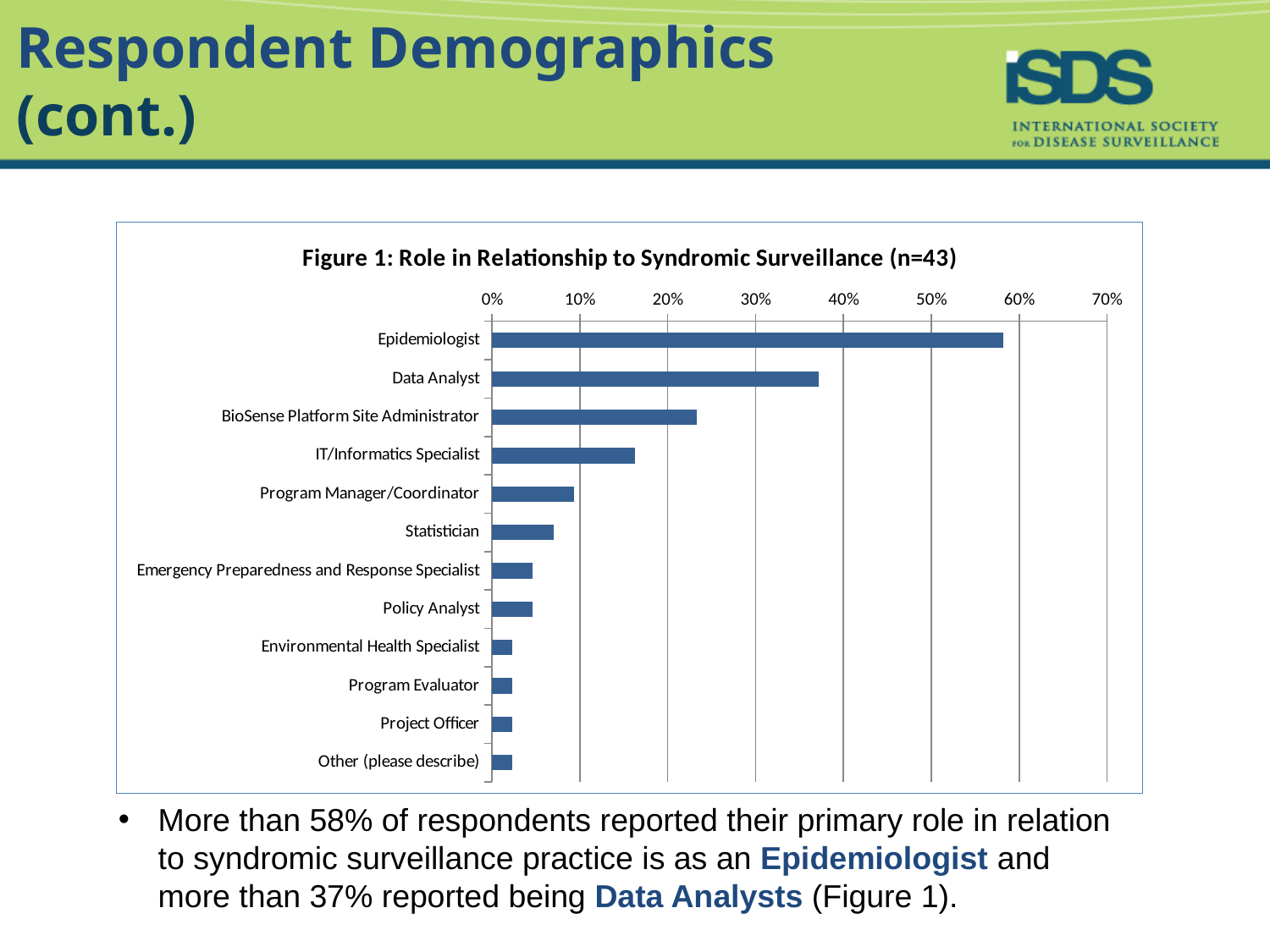
How many role categories are plotted in the chart? 12 What is the highest percentage shown on the horizontal axis? 70% Which role has the highest percentage of respondents? Epidemiologist What kind of chart is shown in Figure 1? bar chart Is the value for Epidemiologist greater or less than 50%? greater Which has a larger value, Statistician or IT/Informatics Specialist? IT/Informatics Specialist What is the title of the chart? Figure 1: Role in Relationship to Syndromic Surveillance (n=43) Is the value for BioSense Platform Site Administrator greater or less than 20%? greater Is the value for Data Analyst greater or less than 30%? greater Which has a larger value, Data Analyst or BioSense Platform Site Administrator? Data Analyst